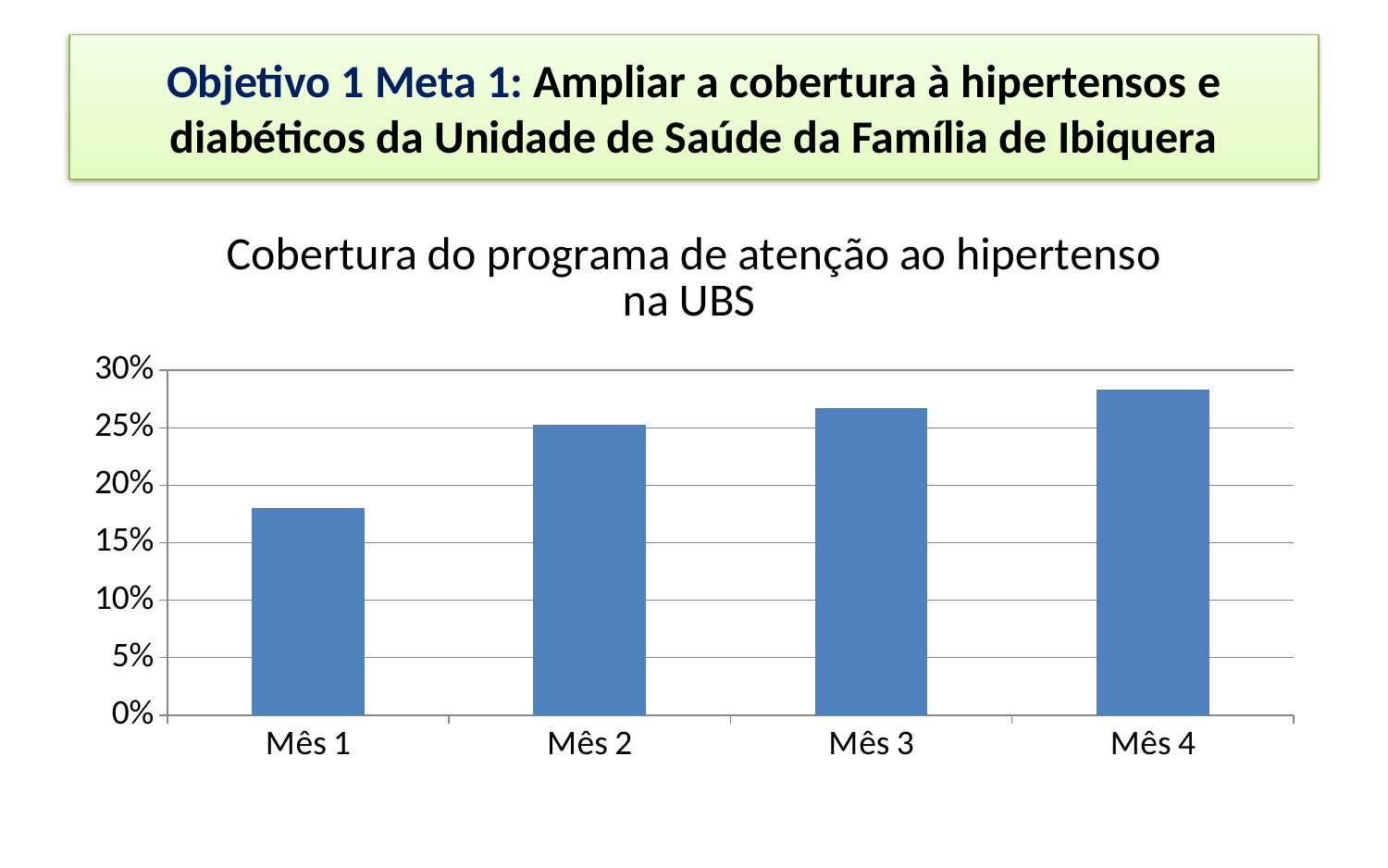
Is the value for Mês 4 greater or less than 30%? less Which is larger, the value for Mês 1 or the value for Mês 2? Mês 2 Which month has the lowest coverage value? Mês 1 Is the value for Mês 3 greater or less than 25%? greater Which month has the highest coverage value? Mês 4 What is the highest value shown on the vertical axis? 30% Do the values rise or fall from Mês 1 to Mês 4? rise Is the value for Mês 1 greater or less than 20%? less What kind of chart is shown on the slide? bar chart What is the title of the chart? Cobertura do programa de atenção ao hipertenso na UBS How many categories (months) are plotted on the chart? 4